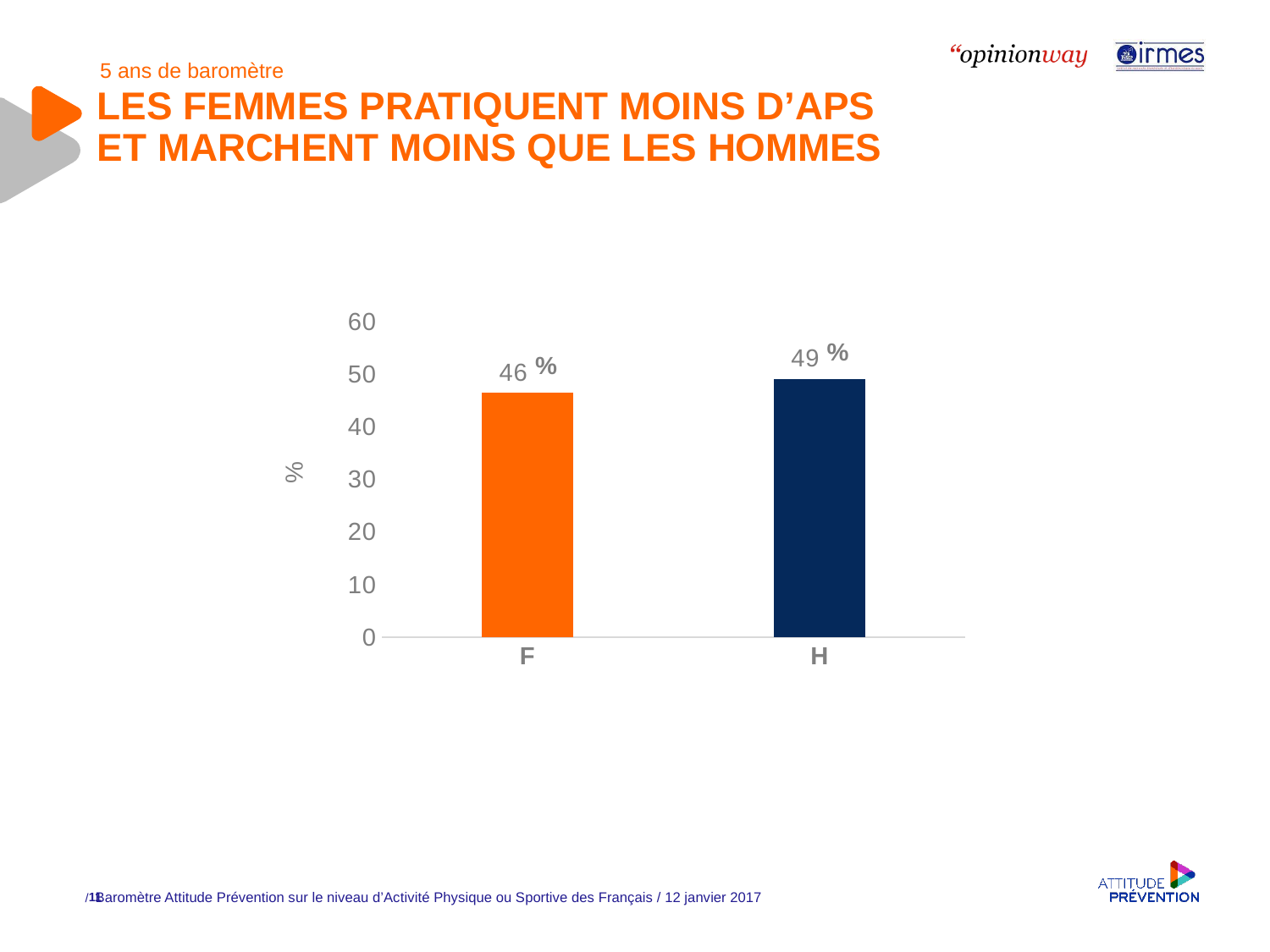
Which category has the lowest value? F What is the value for F? 46 % What is the value for H? 49 % What colour is the bar for F? orange Which is larger, the value for F or the value for H? H How many categories are shown on the x axis? 2 What is the difference between the values for H and F? 3 % Which category has the highest value? H What is the label of the vertical axis? % Is the value for H greater or less than 50? less Is the value for F greater or less than 40? greater What kind of chart is shown on the slide? bar chart